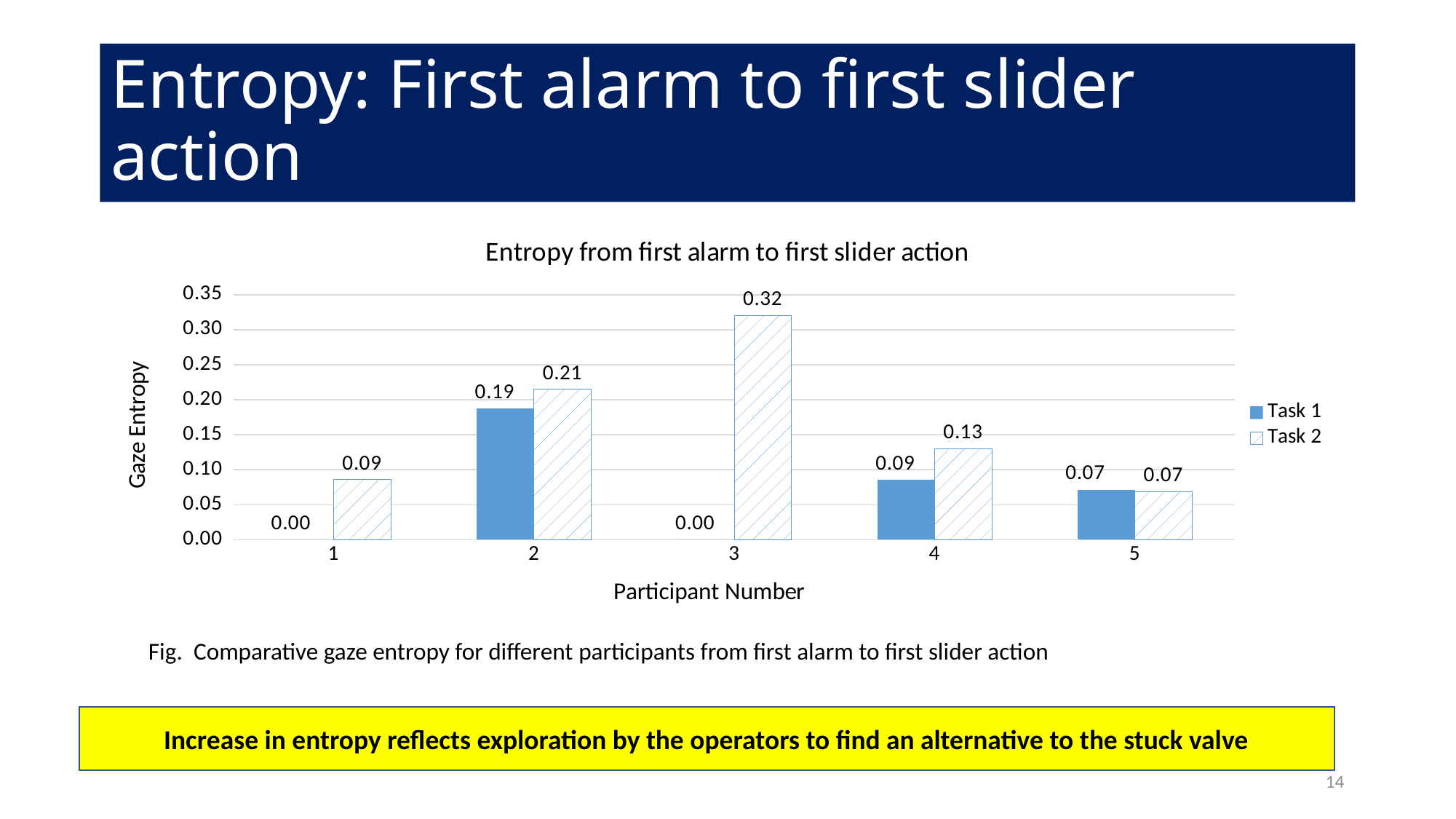
What kind of chart is shown on the slide? bar chart For participant 2, which is larger: the Task 1 value or the Task 2 value? Task 2 Which participant has the highest Task 1 gaze entropy? 2 How many series does the legend list? 2 Is the Task 2 value for participant 3 greater or less than 0.30? greater What is the difference between the Task 2 and Task 1 values for participant 4? 0.04 What is the title of the chart? Entropy from first alarm to first slider action Which participant has the highest Task 2 gaze entropy? 3 How many participants are shown on the x axis? 5 What is the Task 2 gaze entropy value for participant 3? 0.32 What is the Task 1 value for participant 1? 0.00 What is the Task 1 gaze entropy value for participant 2? 0.19